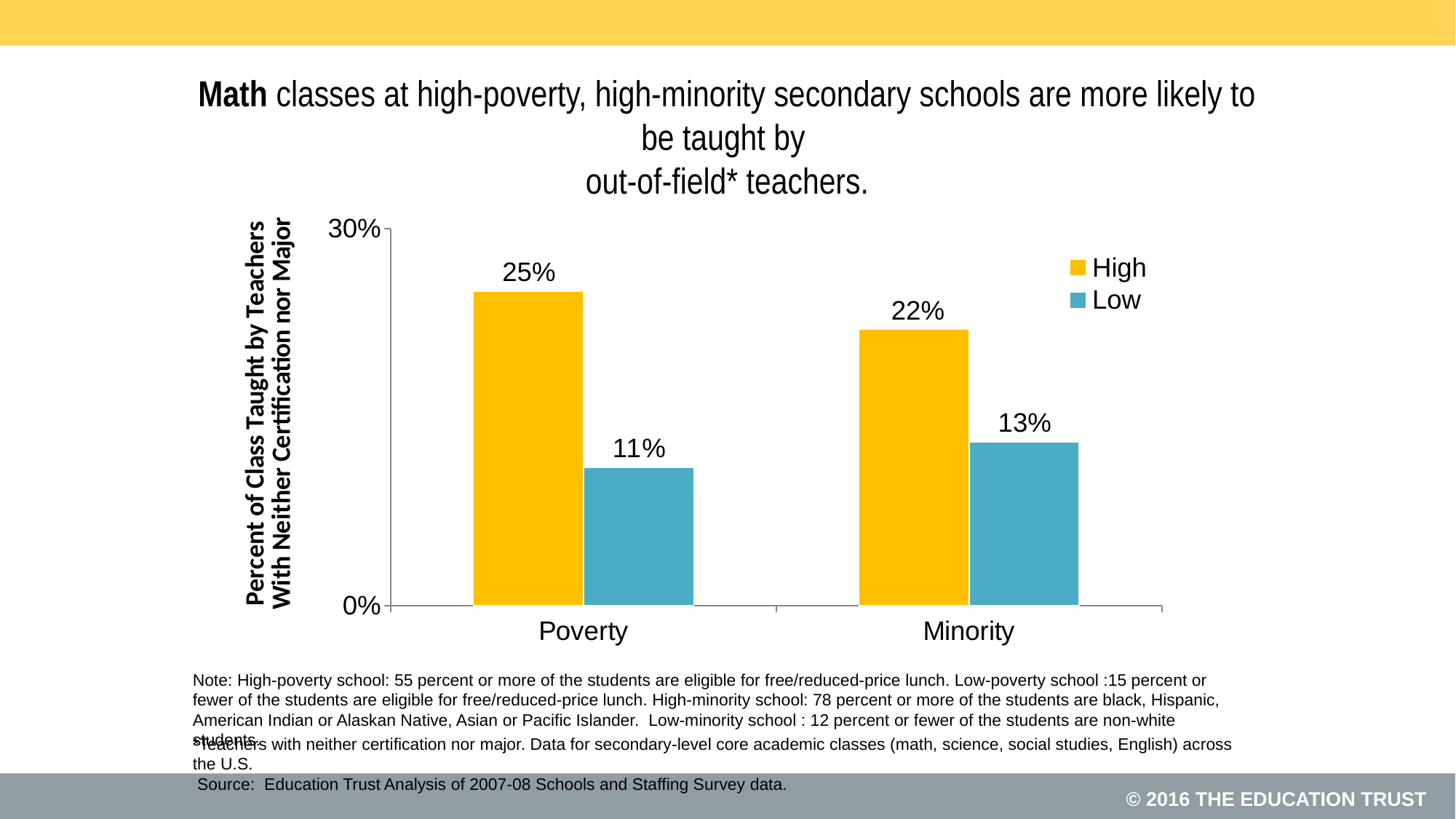
What is the difference between the High and Low values in the Poverty category? 14% How many series does the legend list? 2 How many categories are shown on the x axis? 2 What is the value for High in the Minority category? 22% Which bar has the highest value on the chart? High, Poverty Which bar has the lowest value on the chart? Low, Poverty What is the value for Low in the Minority category? 13% What is the difference between the High and Low values in the Minority category? 9% Which is larger, the High value for Poverty or the High value for Minority? High value for Poverty What kind of chart is shown on the slide? Bar chart What is the value for Low in the Poverty category? 11% What is the value for High in the Poverty category? 25%